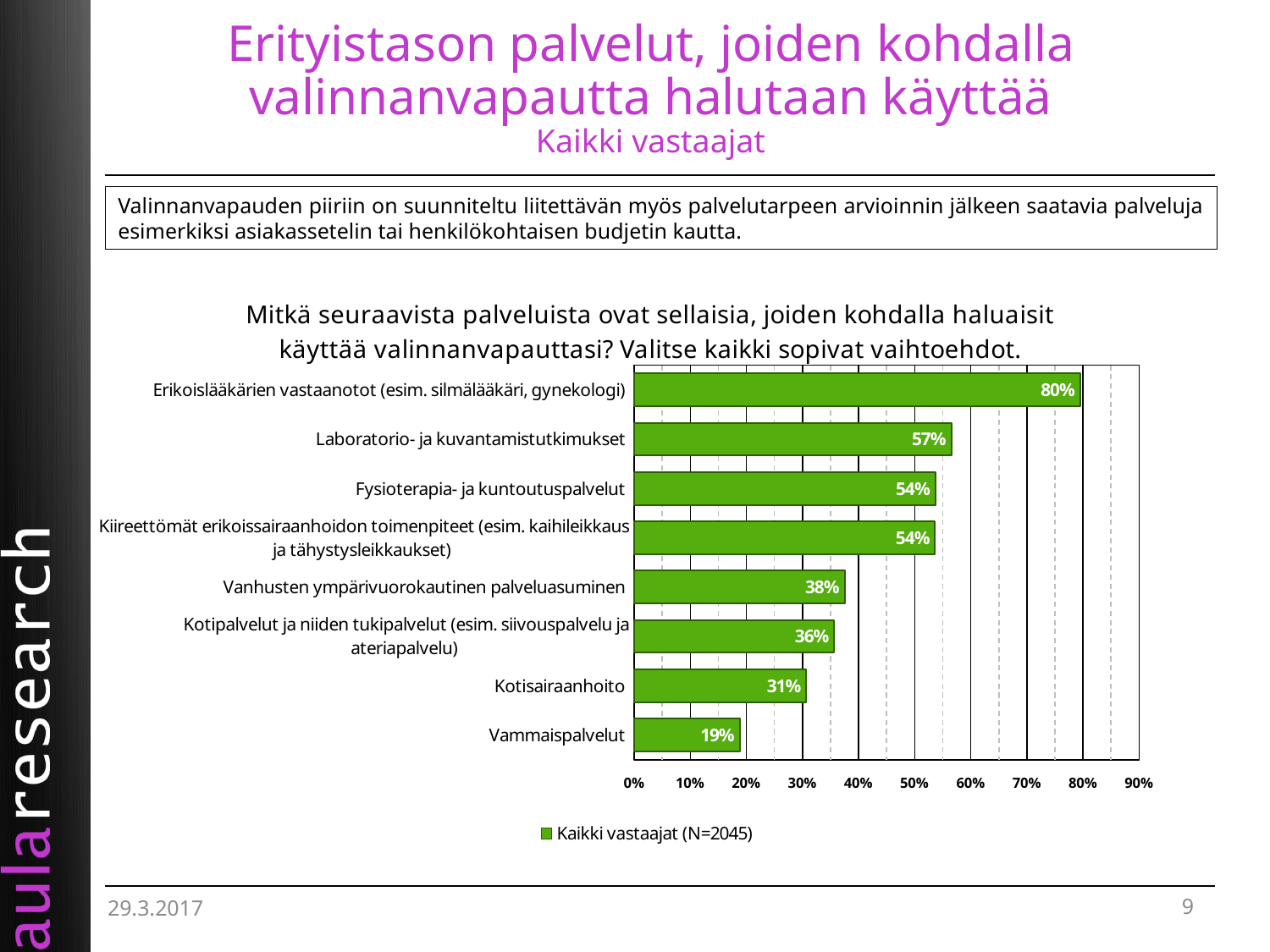
What is the difference between the values for Laboratorio- ja kuvantamistutkimukset and Vammaispalvelut? 38% How many series does the legend list? 1 How many categories are shown in the chart? 8 What is the value for Kotisairaanhoito? 31% What kind of chart is shown on the slide? Bar chart Which is larger, the value for Kotipalvelut ja niiden tukipalvelut (esim. siivouspalvelu ja ateriapalvelu) or the value for Kotisairaanhoito? Kotipalvelut ja niiden tukipalvelut (esim. siivouspalvelu ja ateriapalvelu) What is the legend entry of the chart? Kaikki vastaajat (N=2045) What is the value for Erikoislääkärien vastaanotot (esim. silmälääkäri, gynekologi)? 80% Which category has the lowest value? Vammaispalvelut What is the value for Vanhusten ympärivuorokautinen palveluasuminen? 38% Is the value for Fysioterapia- ja kuntoutuspalvelut greater or less than 50%? greater Which category has the highest value? Erikoislääkärien vastaanotot (esim. silmälääkäri, gynekologi)